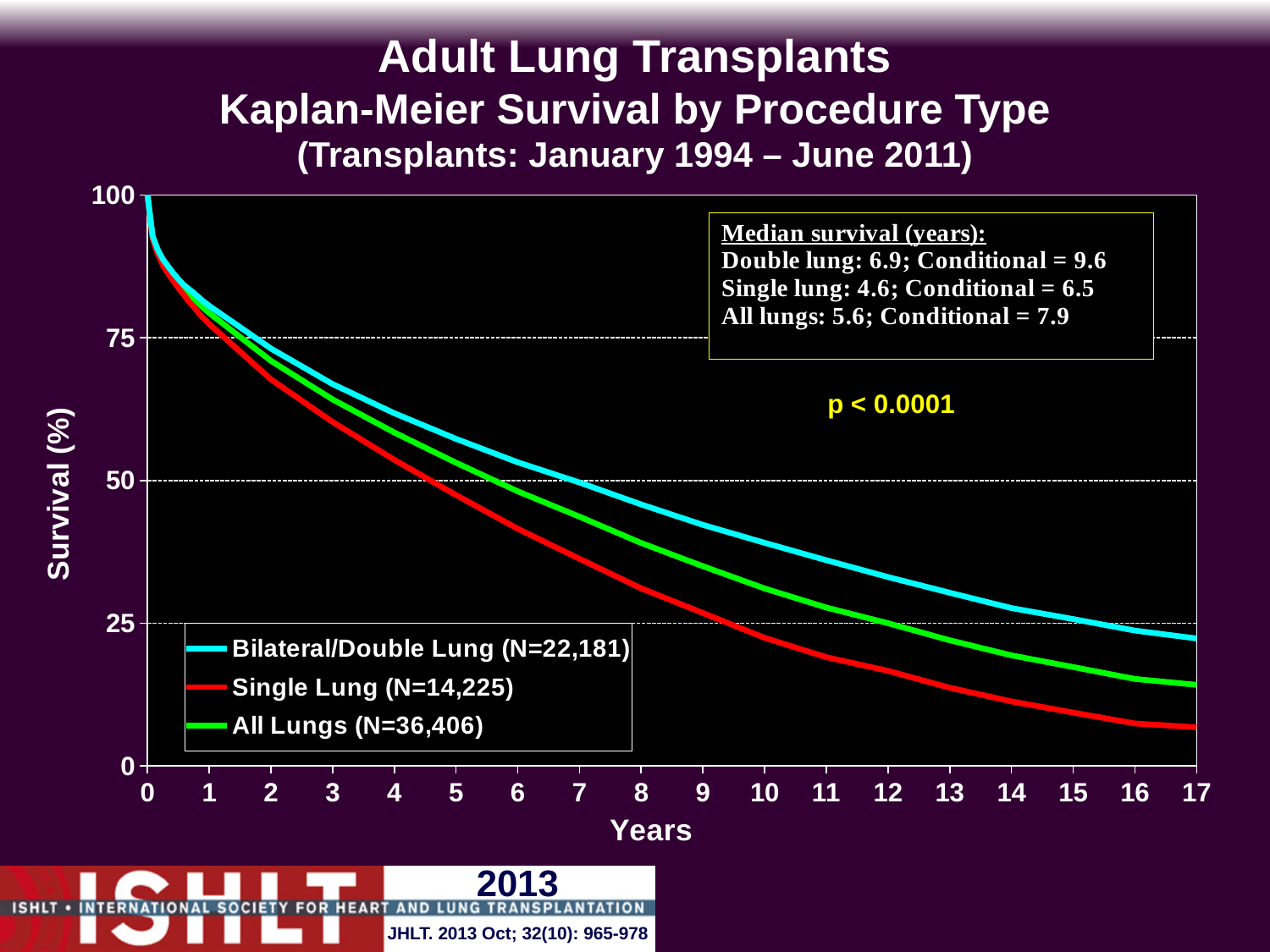
How many series does the legend list? 3 Do the survival curves rise or fall as years increase? fall Is the survival value for Bilateral/Double Lung at 10 years greater or less than 50? less At 12 years, which curve is higher: Bilateral/Double Lung or Single Lung? Bilateral/Double Lung What is the median survival in years for all lungs? 5.6 Is the survival value for Single Lung at 17 years greater or less than 25? less Which procedure type has the highest median survival? Double lung What kind of chart is shown on the slide? line chart What is the median survival in years for double lung transplants? 6.9 What is the difference in median survival (years) between double lung and single lung transplants? 2.3 What is the conditional median survival in years for single lung transplants? 6.5 What is the N for the Single Lung series shown in the legend? 14,225